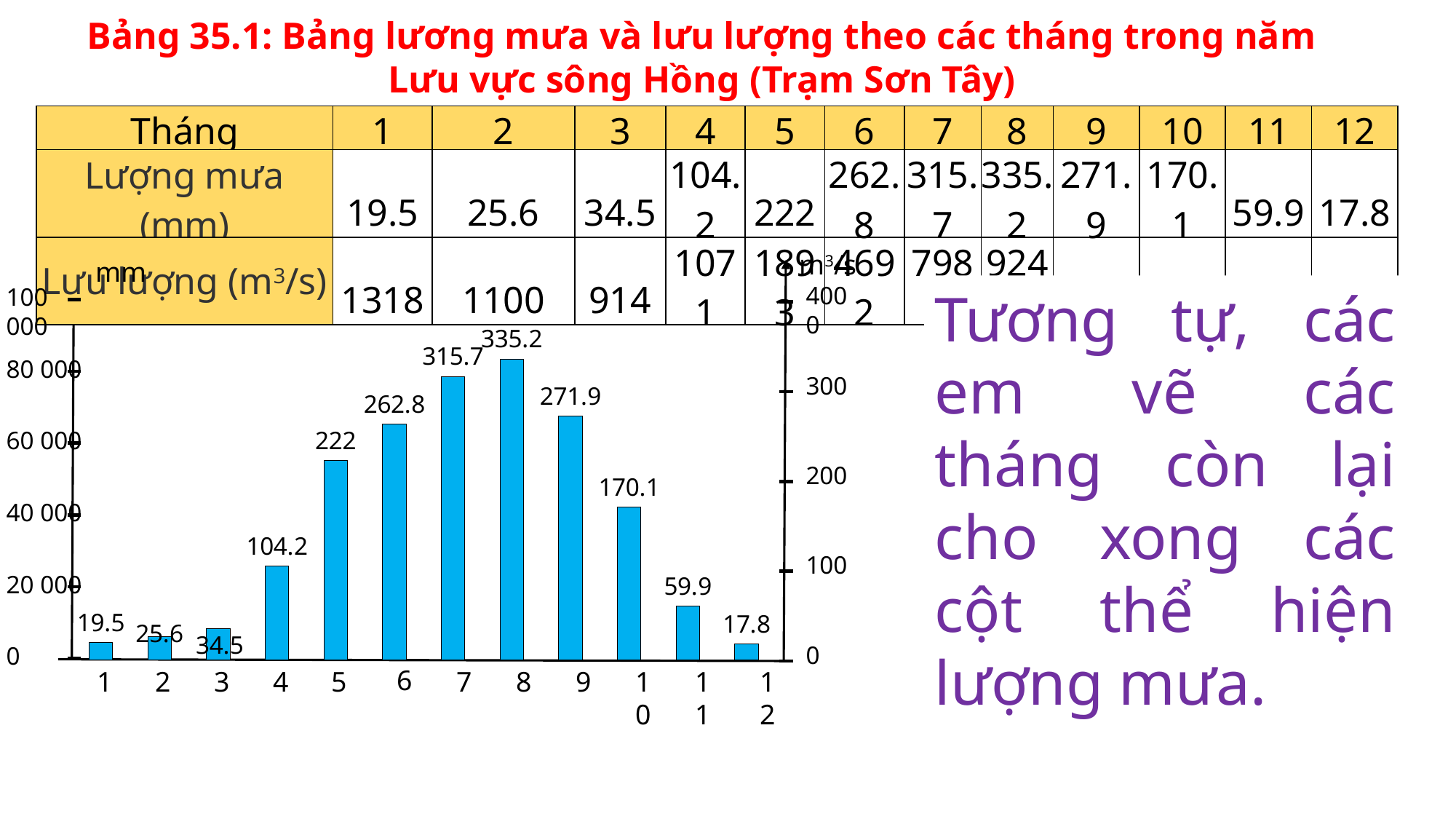
Which month has the lowest rainfall bar? 12 What is the difference between the rainfall values for month 8 and month 7? 19.5 What is the rainfall value shown for month 8? 335.2 How many months (bars) are plotted in the chart? 12 Do the rainfall bars rise or fall from month 8 to month 12? fall What is the rainfall value shown for month 5? 222 What type of chart is shown on the slide? bar chart Which month has the highest rainfall bar? 8 What unit label is shown at the top of the right-hand axis of the chart? m³/s What is the difference between the rainfall values for month 6 and month 5? 40.8 Which month has a larger rainfall value, month 9 or month 10? 9 What is the rainfall value shown for month 11? 59.9